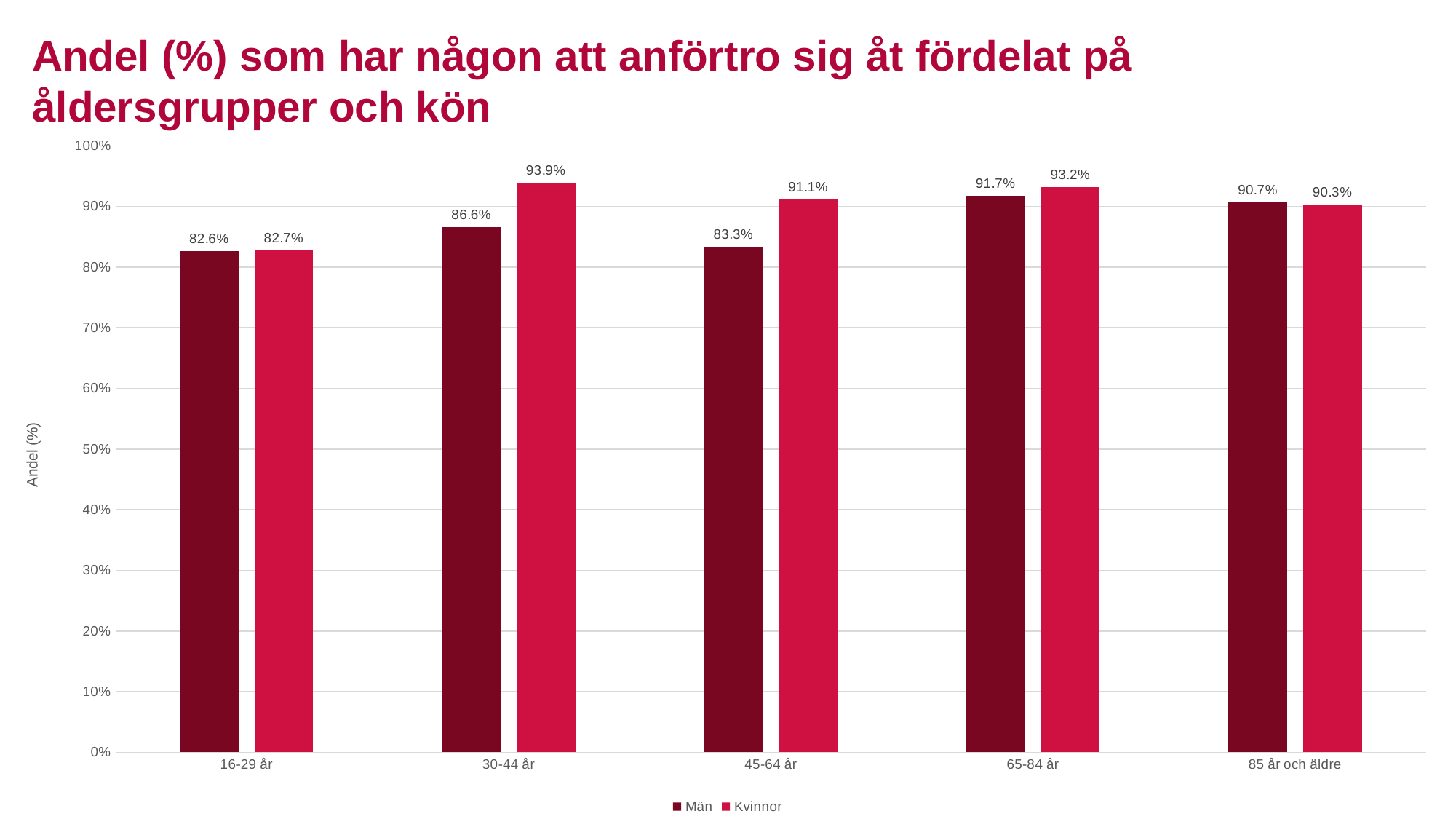
What is the difference between Kvinnor and Män in the 30-44 år age group? 7.3 percentage points What is the value for Män in the 85 år och äldre age group? 90.7% What kind of chart is shown on the slide? Bar chart Which age group has the lowest value for Män? 16-29 år What is the value for Män in the 30-44 år age group? 86.6% Is the value for Män in the 45-64 år age group greater or less than 90%? less What is the value for Kvinnor in the 45-64 år age group? 91.1% How many series does the legend list? 2 How many age groups are shown on the x axis? 5 What is the label of the y axis? Andel (%) Which is larger in the 65-84 år age group, Män or Kvinnor? Kvinnor Which age group has the highest value for Kvinnor? 30-44 år